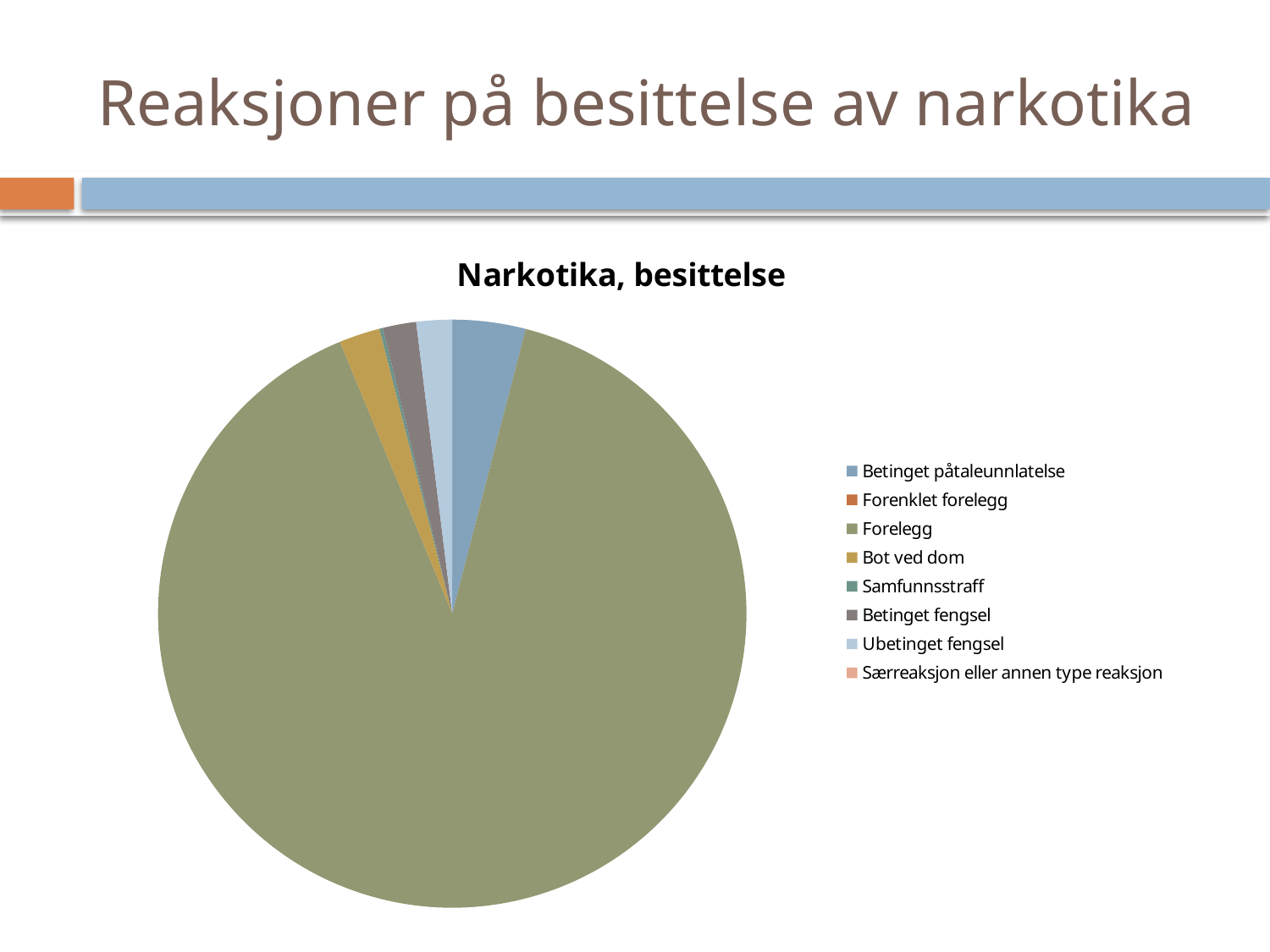
Which category is listed first in the legend? Betinget påtaleunnlatelse What kind of chart is shown on the slide? pie chart Which category has the largest slice of the pie? Forelegg Which is larger, the slice for Forelegg or the slice for Betinget påtaleunnlatelse? Forelegg What is the title of the chart? Narkotika, besittelse Does the Forelegg slice account for more or less than half of the pie? more Which is larger, the slice for Forelegg or the slice for Ubetinget fengsel? Forelegg How many categories does the legend of the chart list? 8 Which is larger, the slice for Betinget påtaleunnlatelse or the slice for Bot ved dom? Betinget påtaleunnlatelse